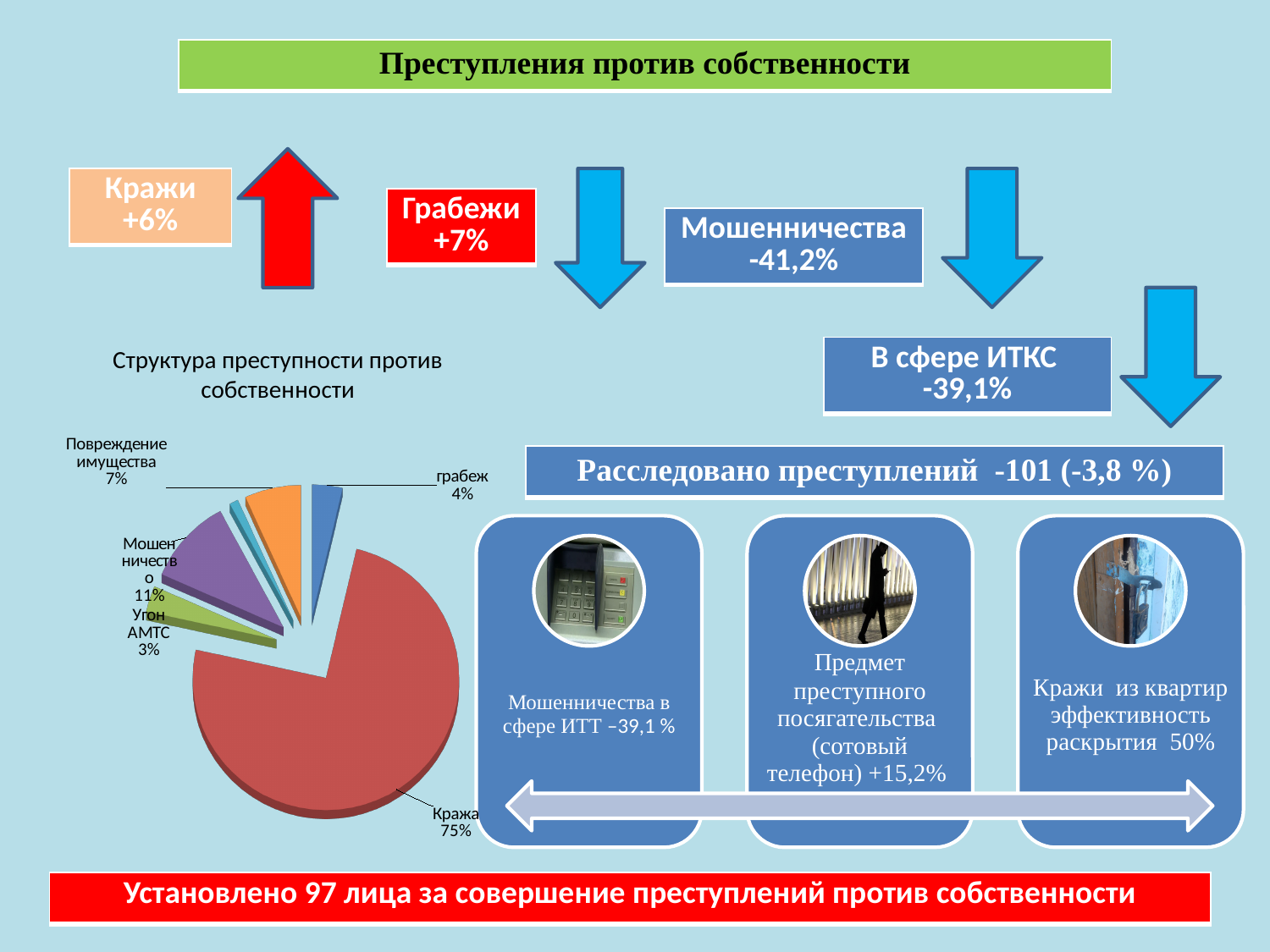
In the pie chart, what share is labelled for "Угон АМТС"? 3% Which labelled slice of the pie chart is the largest? Кража In the pie chart, what is the difference in percentage points between "Повреждение имущества" and "Угон АМТС"? 4 In the pie chart, what share is labelled for "грабеж"? 4% In the pie chart, what share is labelled for "Повреждение имущества"? 7% In the pie chart, what is the difference in percentage points between "Кража" and "Мошенничество"? 64 Which labelled slice of the pie chart is the smallest? Угон АМТС In the pie chart, what share is labelled for "Кража"? 75% In the pie chart, which is larger: "Повреждение имущества" or "грабеж"? Повреждение имущества What is the title written above the pie chart? Структура преступности против собственности In the pie chart, what share is labelled for "Мошенничество"? 11% What kind of chart is shown under the heading "Структура преступности против собственности"? pie chart